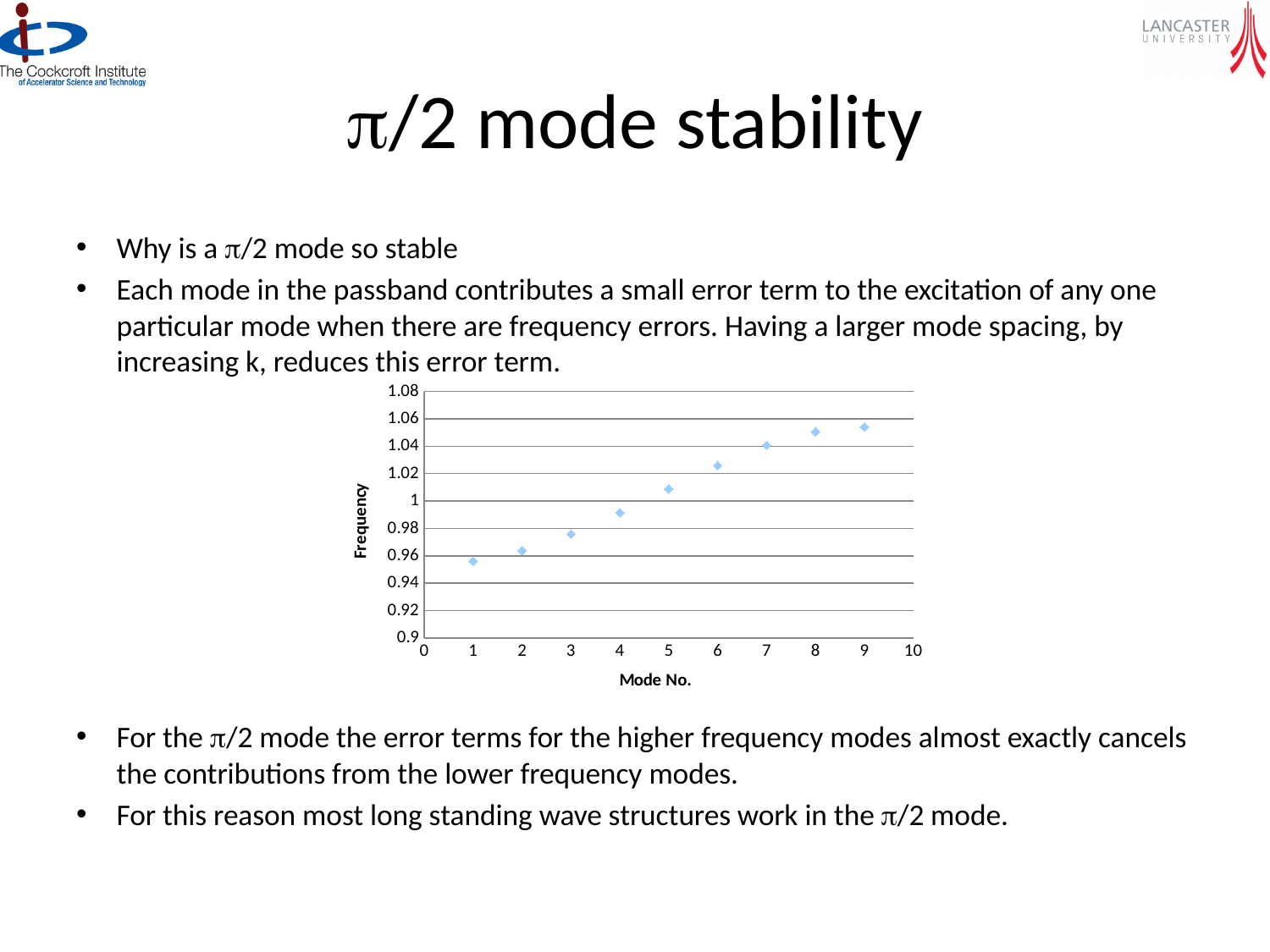
Is the frequency for mode 9 greater or less than 1.04? greater Is the frequency for mode 7 greater or less than 1.02? greater Which mode number has the lowest frequency? 1 How many data points are plotted in the chart? 9 Is the frequency for mode 1 greater or less than 0.98? less Do the frequency values rise or fall as the mode number increases? rise What kind of chart is shown on the slide? scatter chart Which has the larger frequency, mode 3 or mode 7? mode 7 What is the label on the vertical axis of the chart? Frequency Which mode number has the highest frequency? 9